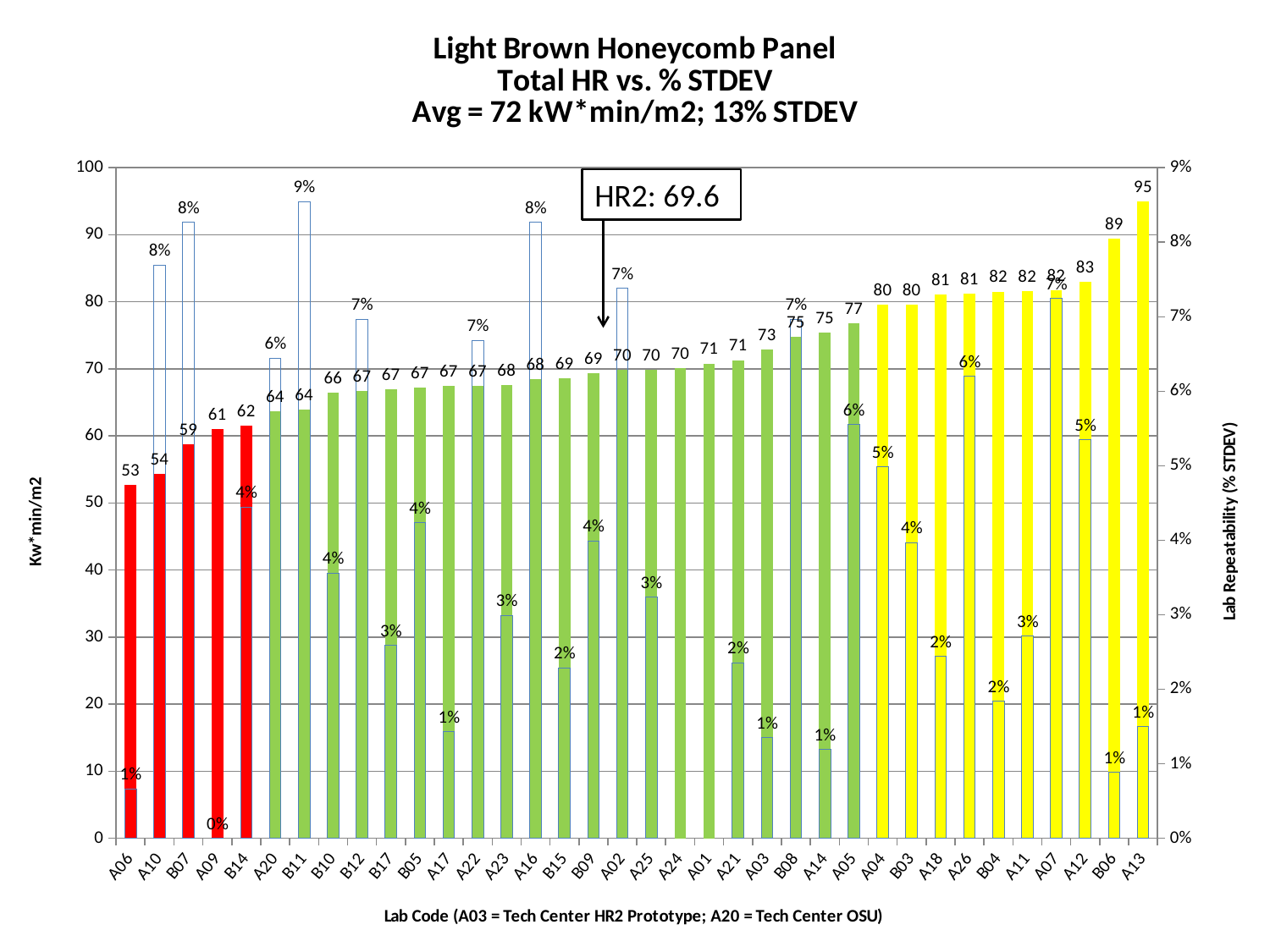
Do the Kw*min/m2 values rise or fall from left to right along the x axis? rise What HR2 value is shown in the annotation box on the chart? 69.6 What is the lab repeatability (% STDEV) for lab A09? 0% Which lab has the highest lab repeatability (% STDEV)? B11 What is the lab repeatability (% STDEV) for lab B11? 9% What is the Kw*min/m2 value for lab A13? 95 What is the difference in Kw*min/m2 between lab A13 and lab A06? 42 How many lab codes are shown on the x axis? 36 Which lab code has the lowest Kw*min/m2 value? A06 What kind of chart is shown on the slide? bar chart Which lab code has the highest Kw*min/m2 value? A13 Which lab has the larger Kw*min/m2 value, B06 or A12? B06